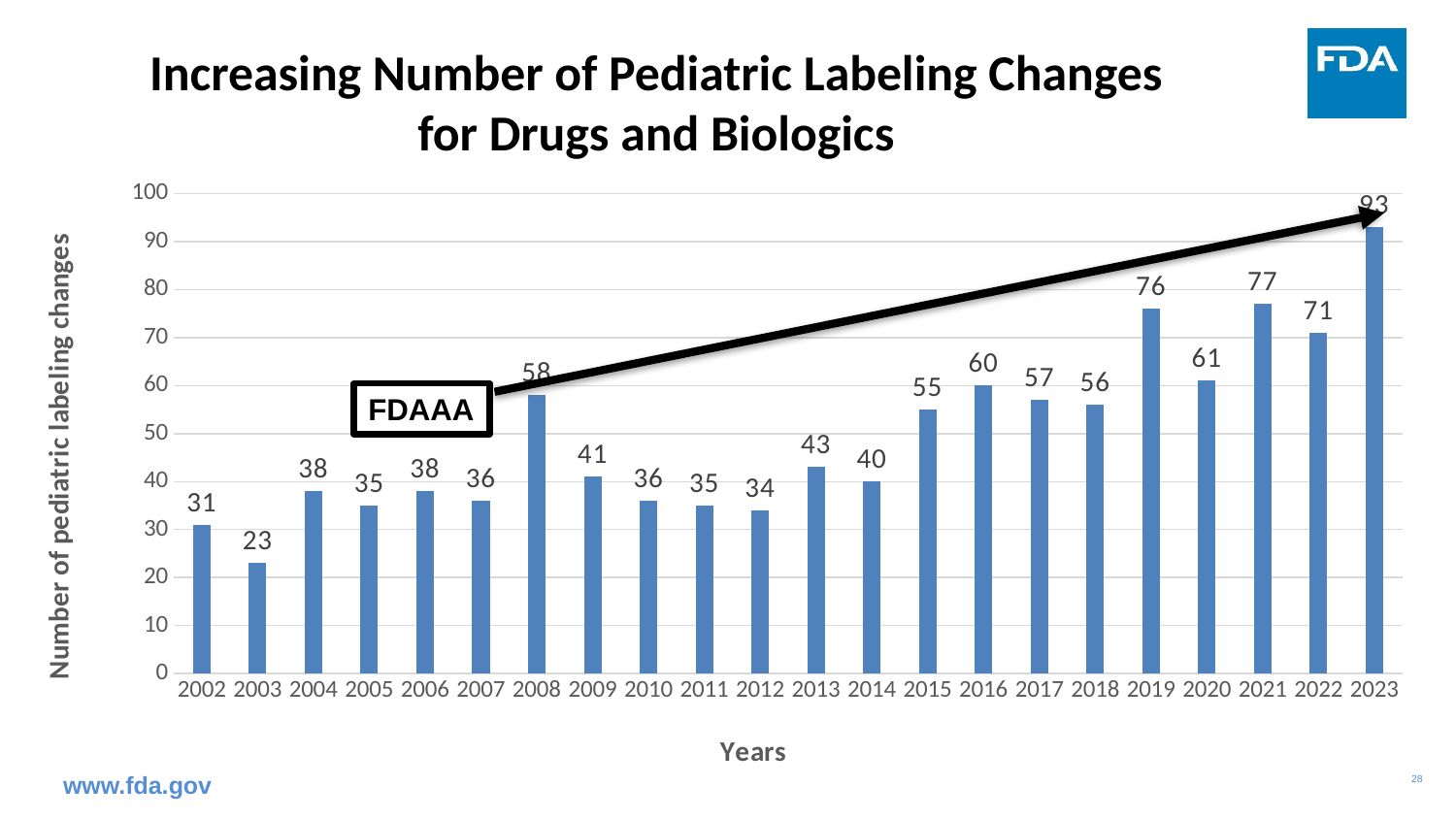
Is the value for 2023 greater or less than 90? greater What type of chart is shown on the slide? bar chart Which year has the lowest number of pediatric labeling changes? 2003 What is the number of pediatric labeling changes for 2019? 76 Which year has the highest number of pediatric labeling changes? 2023 What is the value shown for 2003? 23 How many years are shown on the x axis? 22 How many pediatric labeling changes were there in 2008? 58 What text appears in the boxed annotation near the 2007 bar? FDAAA Which year has a larger value, 2016 or 2017? 2016 What is the label of the y axis? Number of pediatric labeling changes What is the difference between the values for 2021 and 2020? 16